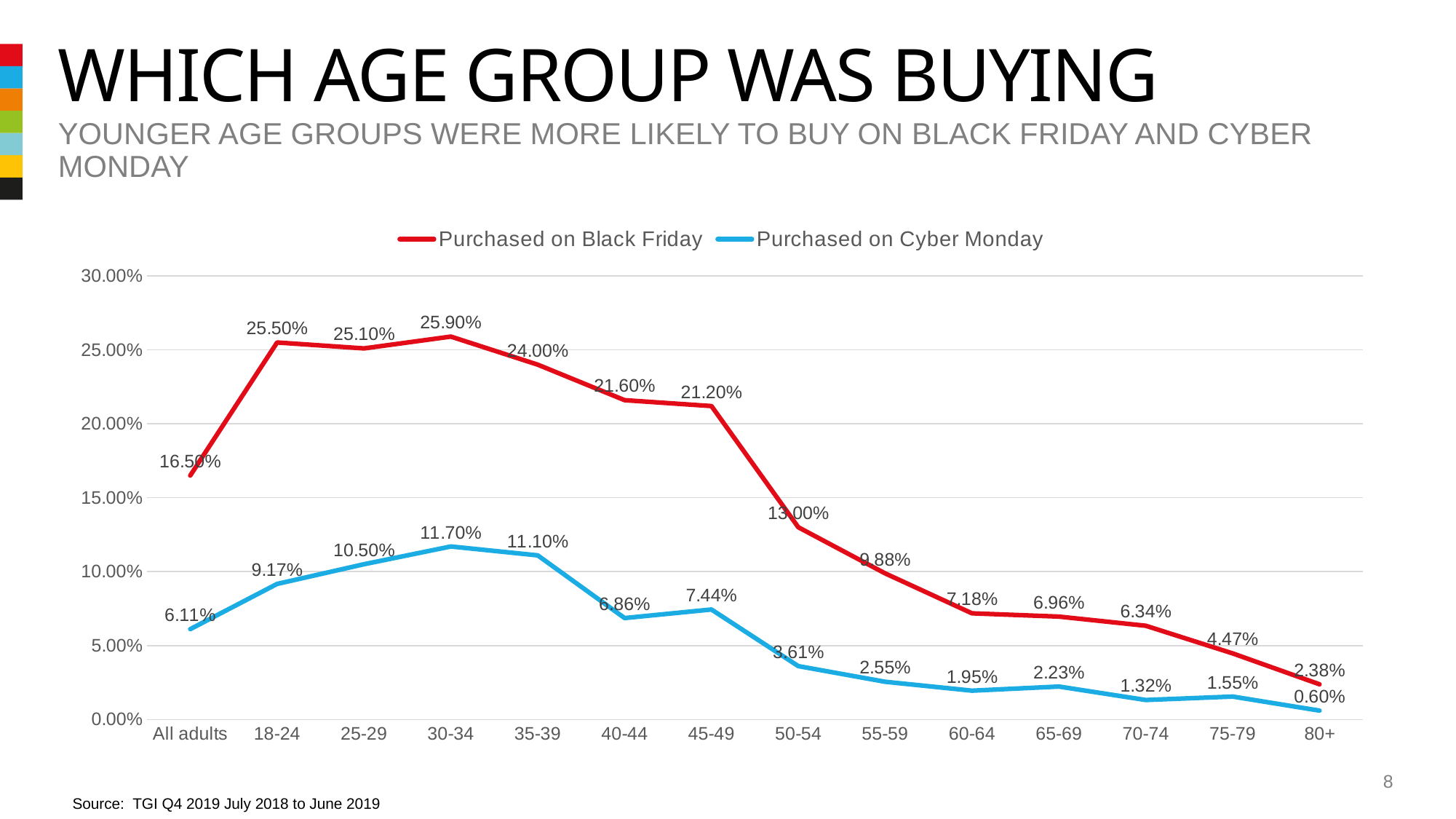
From the 30-34 age group to the 80+ age group, do the Purchased on Black Friday values rise or fall? Fall Which age group has the lowest value for Purchased on Cyber Monday? 80+ What is the value for All adults on the Purchased on Black Friday line? 16.50% How many series does the legend list? 2 Which age group has the highest value for Purchased on Black Friday? 30-34 What percentage of the 18-24 age group purchased on Black Friday? 25.50% What colour is the Purchased on Cyber Monday line? Blue What percentage of the 30-34 age group purchased on Cyber Monday? 11.70% Which is larger for the 65-69 age group: the Black Friday value or the Cyber Monday value? Black Friday What kind of chart is shown on the slide? Line chart How many age categories are shown on the x axis? 14 What is the difference between the Black Friday and Cyber Monday values for the 50-54 age group? 9.39%